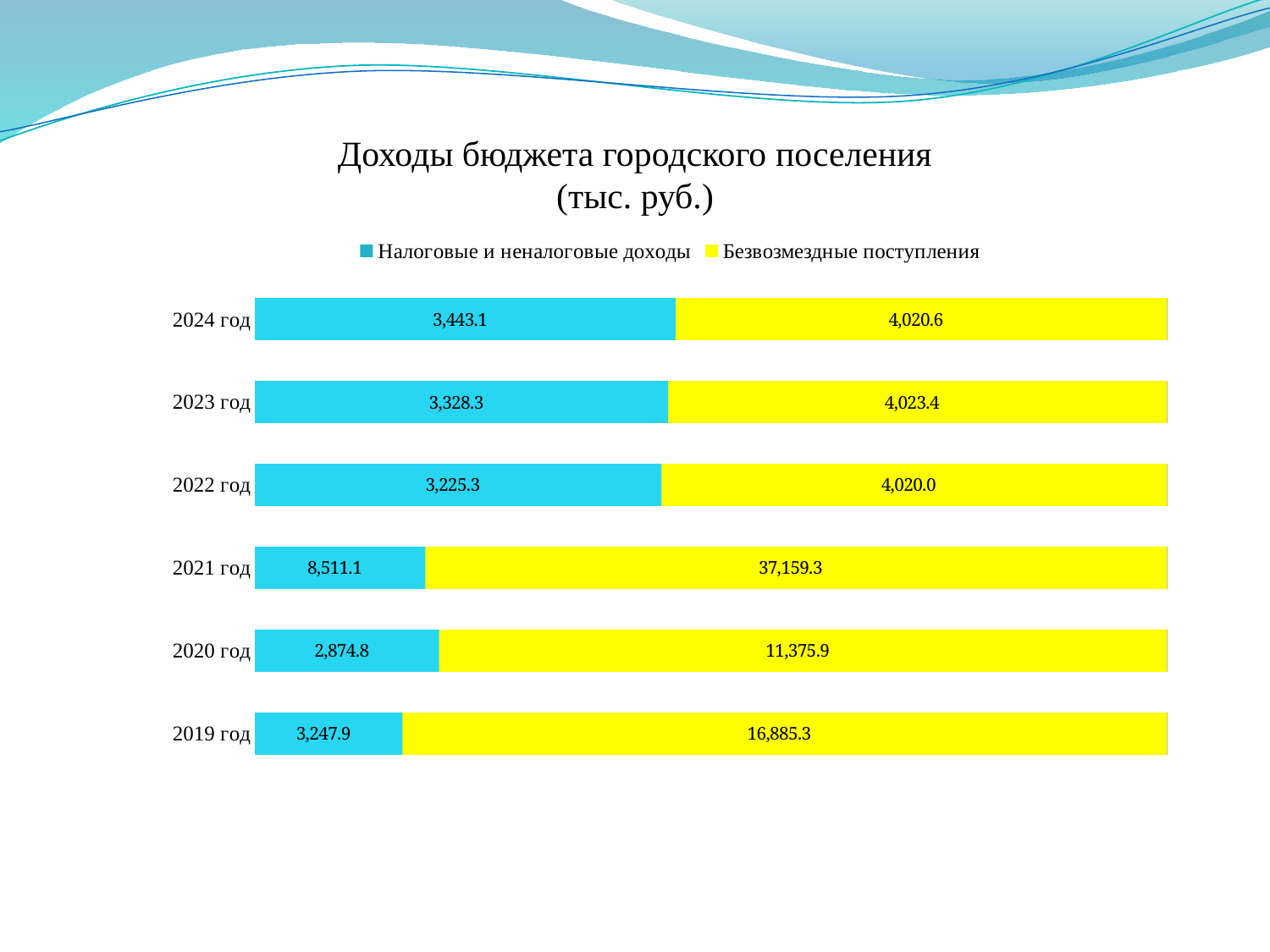
What is the value of Безвозмездные поступления for 2019 год? 16,885.3 What is the value of Налоговые и неналоговые доходы for 2024 год? 3,443.1 Which year has the highest value of Налоговые и неналоговые доходы? 2021 год How many series does the legend list? 2 How many years are shown in the chart? 6 Which year has the highest value of Безвозмездные поступления? 2021 год What is the total of the bar for 2020 год? 14,250.7 Which year has the lowest value of Налоговые и неналоговые доходы? 2020 год What type of chart is shown on the slide? Stacked bar chart What is the difference between Безвозмездные поступления and Налоговые и неналоговые доходы for 2021 год? 28,648.2 Which is larger: Налоговые и неналоговые доходы for 2024 год or for 2023 год? 2024 год What is the value of Безвозмездные поступления for 2021 год? 37,159.3